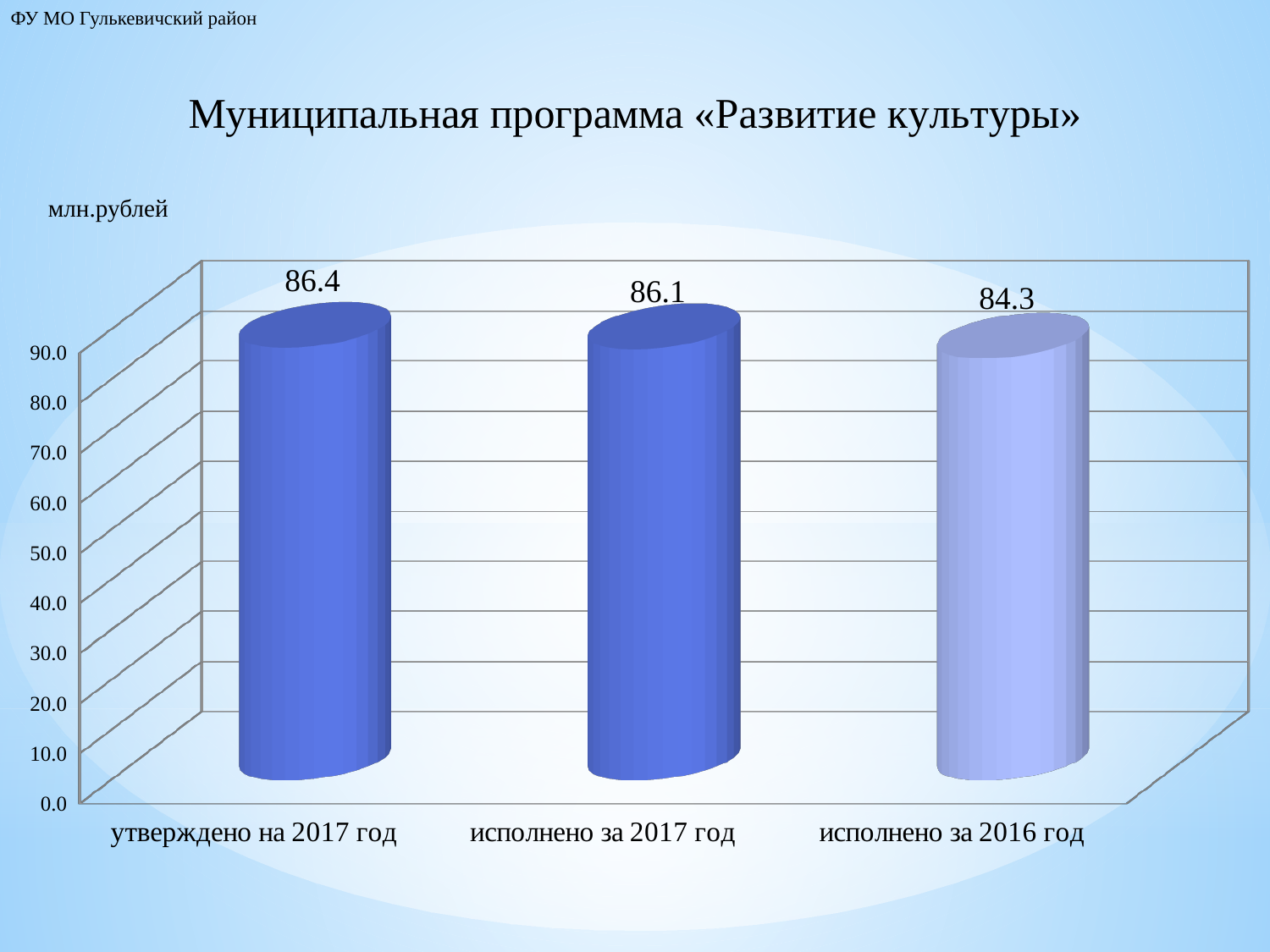
What unit is indicated above the chart? млн.рублей What is the value for «исполнено за 2017 год»? 86.1 What is the difference between «исполнено за 2017 год» and «исполнено за 2016 год»? 1.8 What kind of chart is shown on the slide? bar chart Is the value for «исполнено за 2016 год» greater or less than 80.0? greater What is the value for «исполнено за 2016 год»? 84.3 Which is larger: «исполнено за 2017 год» or «исполнено за 2016 год»? исполнено за 2017 год Which category has the highest value? утверждено на 2017 год What is the value for «утверждено на 2017 год»? 86.4 What is the difference between «утверждено на 2017 год» and «исполнено за 2017 год»? 0.3 How many categories are shown in the chart? 3 Which category has the lowest value? исполнено за 2016 год